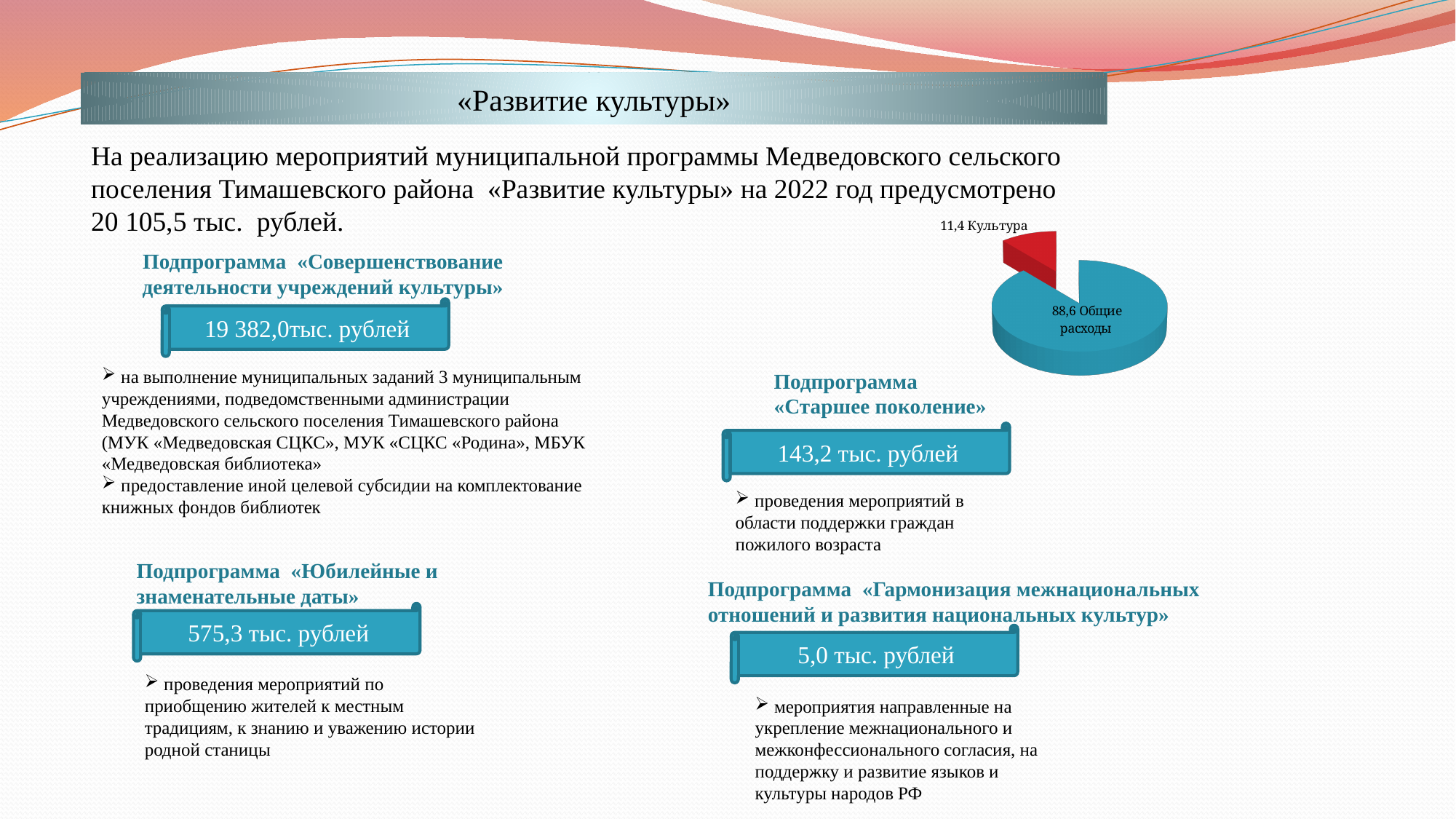
Which slice of the pie chart is the smallest? Культура Which slice of the pie chart is the largest? Общие расходы What colour is the Культура slice of the pie chart? red What value is shown for the Культура slice of the pie chart? 11,4 What is the difference between the Общие расходы value and the Культура value in the pie chart? 77,2 What is the total of the two values shown in the pie chart? 100 What kind of chart is shown on the slide? pie chart What value is shown for the Общие расходы slice of the pie chart? 88,6 What colour is the Общие расходы slice of the pie chart? blue How many slices does the pie chart have? 2 Which is larger in the pie chart, Культура or Общие расходы? Общие расходы